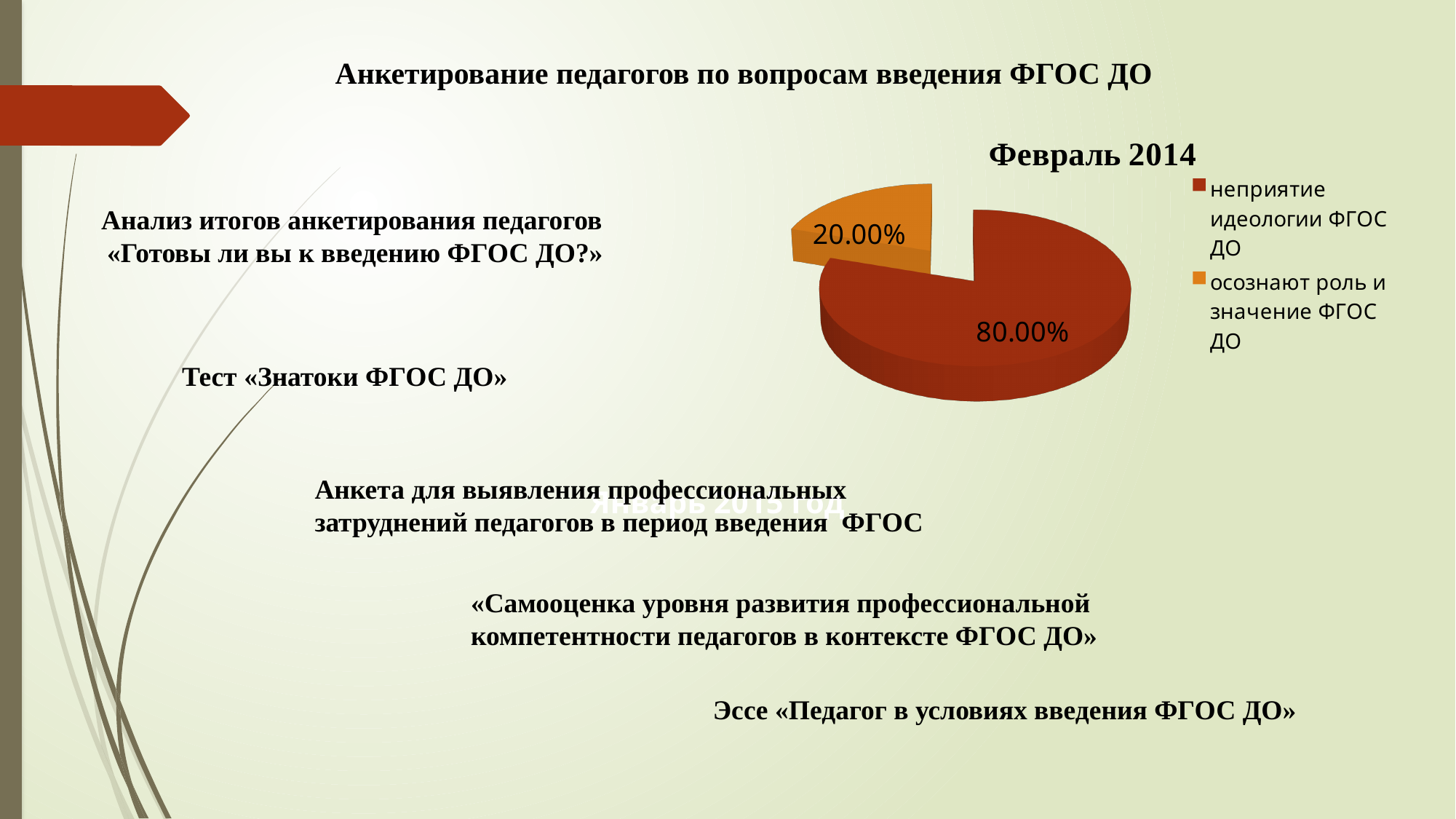
Which slice of the pie is the smallest? осознают роль и значение ФГОС ДО How many entries does the legend of the pie chart list? 2 What is the difference between the two slices of the pie? 60.00% How many slices does the pie chart have? 2 What kind of chart is shown on the slide? pie chart What is the title of the pie chart? Февраль 2014 What colour is the slice for "осознают роль и значение ФГОС ДО"? orange What share of the pie is labelled "осознают роль и значение ФГОС ДО"? 20.00% What share of the pie is labelled "неприятие идеологии ФГОС ДО"? 80.00% Which is larger: the slice for "неприятие идеологии ФГОС ДО" or the slice for "осознают роль и значение ФГОС ДО"? неприятие идеологии ФГОС ДО Which slice of the pie is the largest? неприятие идеологии ФГОС ДО